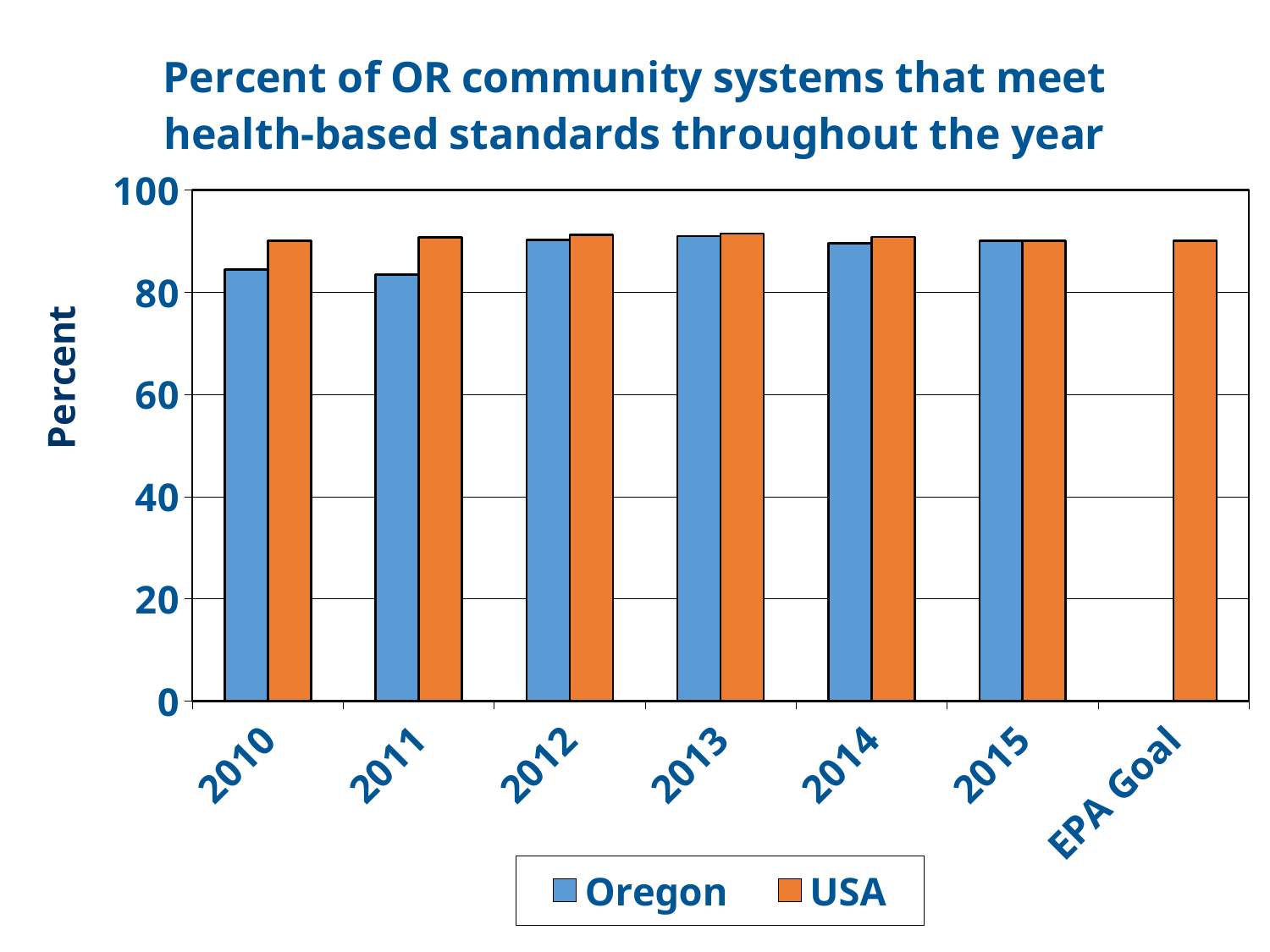
What is the label on the vertical axis? Percent Is the value for Oregon in 2011 greater or less than 90? less What kind of chart is shown on the slide? bar chart Is the value for USA in 2012 greater or less than 80? greater How many series does the legend list? 2 Is the EPA Goal value greater or less than 60? greater Which series does the legend list besides Oregon? USA Do the Oregon values rise or fall from 2011 to 2013? rise In 2010, which is larger, the Oregon value or the USA value? USA In 2011, which is larger, the Oregon value or the USA value? USA How many categories are shown along the x axis? 7